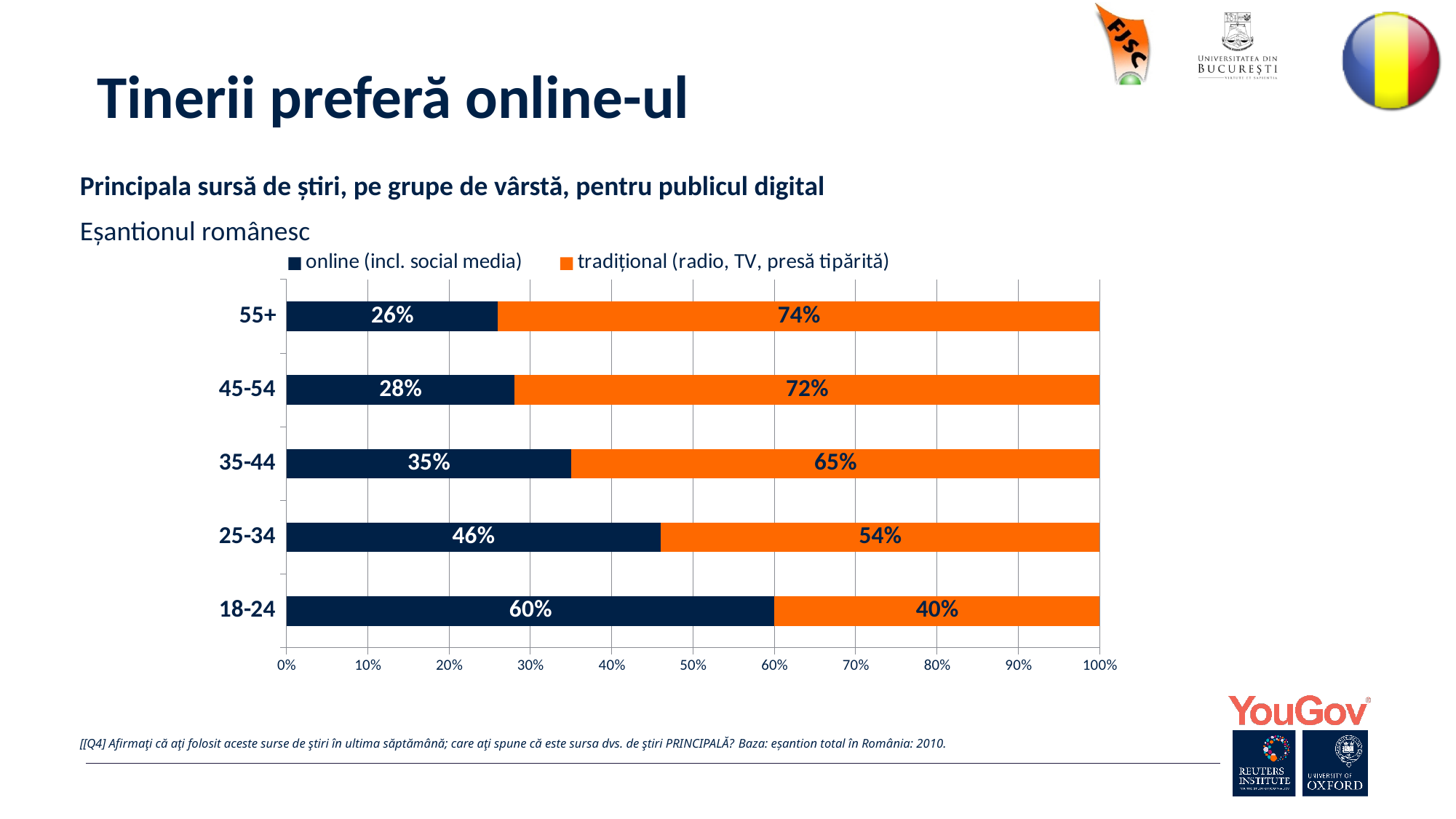
Which age group has the lowest value for tradițional (radio, TV, presă tipărită)? 18-24 What is the value for online (incl. social media) in the 18-24 age group? 60% What is the total of the stacked bar for the 35-44 age group? 100% What is the value for online (incl. social media) in the 35-44 age group? 35% What is the difference between the tradițional and online values in the 25-34 age group? 8% What is the value for tradițional (radio, TV, presă tipărită) in the 55+ age group? 74% How many age groups are shown in the chart? 5 What kind of chart is shown on the slide? stacked bar chart Which age group has the highest value for online (incl. social media)? 18-24 Which is larger in the 45-54 age group: online (incl. social media) or tradițional (radio, TV, presă tipărită)? tradițional (radio, TV, presă tipărită) How many series does the legend list? 2 Which colour represents online (incl. social media) in the chart? dark navy blue